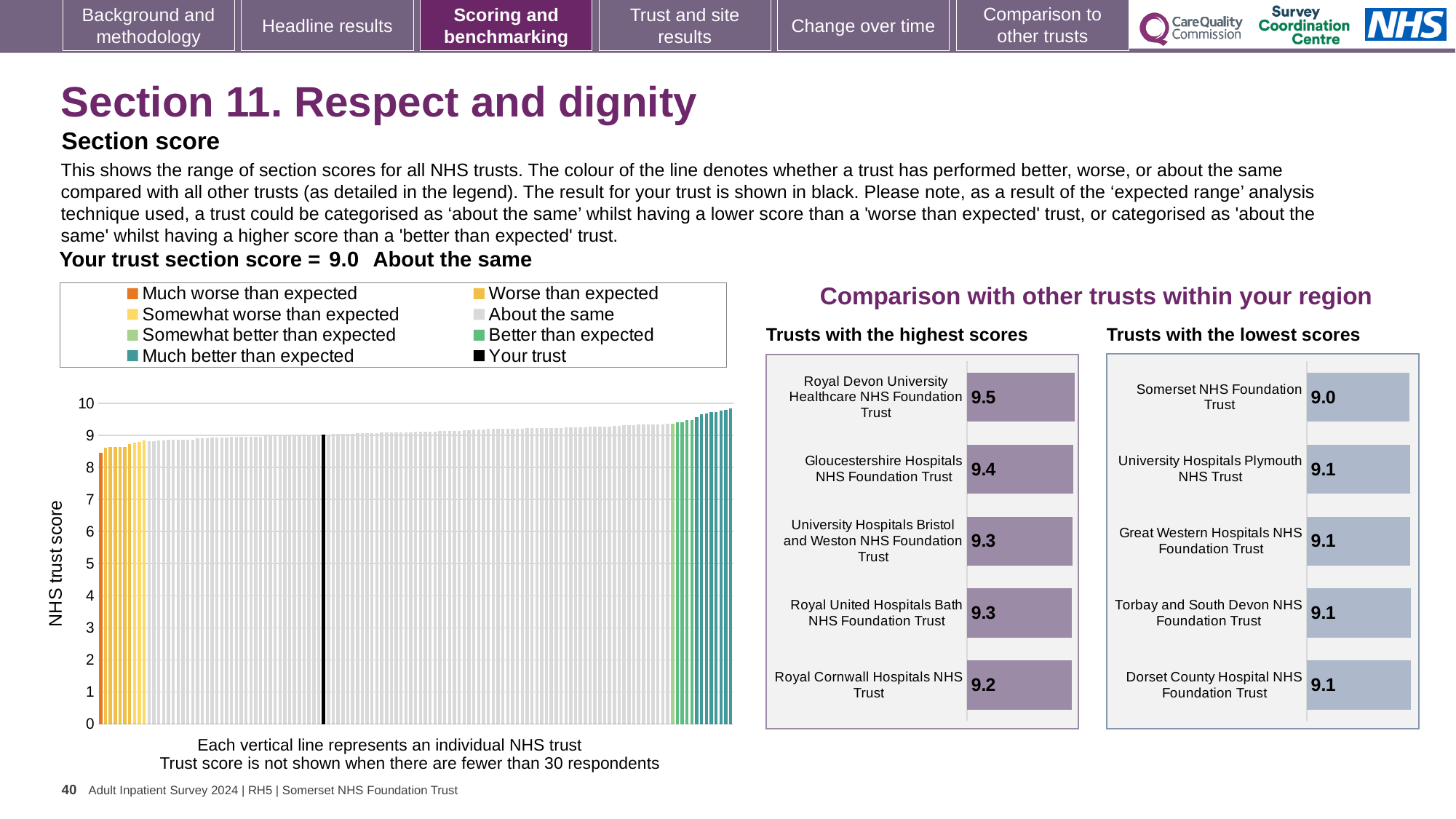
How many entries does the legend of the large chart on the left list? 8 In the 'Trusts with the highest scores' chart, what is the score for Royal Cornwall Hospitals NHS Trust? 9.2 In the 'Trusts with the highest scores' chart, what is the score for Royal Devon University Healthcare NHS Foundation Trust? 9.5 In the 'Trusts with the lowest scores' chart, what is the difference between the scores of University Hospitals Plymouth NHS Trust and Somerset NHS Foundation Trust? 0.1 How many trusts are shown in the 'Trusts with the highest scores' chart? 5 In the 'Trusts with the highest scores' chart, what is the difference between the scores of Royal Devon University Healthcare NHS Foundation Trust and Royal Cornwall Hospitals NHS Trust? 0.3 In the 'Trusts with the highest scores' chart, which trust has the lowest score? Royal Cornwall Hospitals NHS Trust In the 'Trusts with the highest scores' chart, which has the higher score: Gloucestershire Hospitals NHS Foundation Trust or Royal United Hospitals Bath NHS Foundation Trust? Gloucestershire Hospitals NHS Foundation Trust In the 'Trusts with the lowest scores' chart, what is the score for Somerset NHS Foundation Trust? 9.0 In the 'Trusts with the highest scores' chart, which trust has the highest score? Royal Devon University Healthcare NHS Foundation Trust What kind of chart is the large chart on the left showing NHS trust scores? Bar chart In the 'Trusts with the lowest scores' chart, which trust has the lowest score? Somerset NHS Foundation Trust